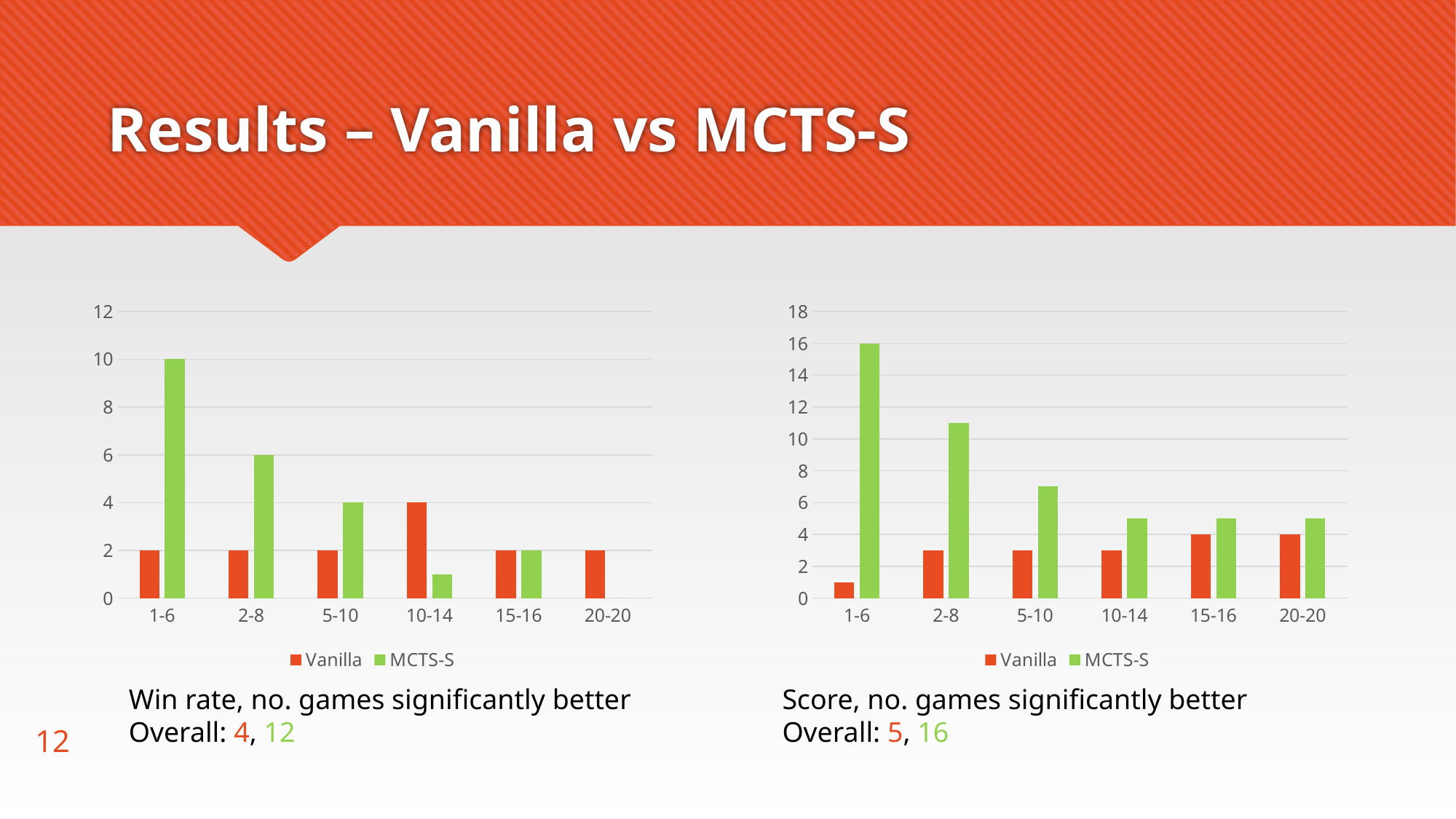
What kind of chart is the right chart (Score, no. games significantly better)? bar chart In the right chart (Score, no. games significantly better), is the Vanilla value for 1-6 greater or less than 2? less In the right chart (Score, no. games significantly better), how many series does the legend list? 2 In the right chart (Score, no. games significantly better), is the MCTS-S value for 2-8 greater or less than 10? greater In the left chart (Win rate, no. games significantly better), what is the Vanilla value for 10-14? 4 In the left chart (Win rate, no. games significantly better), how many categories are shown on the x axis? 6 In the left chart (Win rate, no. games significantly better), what is the difference between the MCTS-S values for 1-6 and 2-8? 4 In the left chart (Win rate, no. games significantly better), what is the MCTS-S value for 1-6? 10 In the left chart (Win rate, no. games significantly better), which category has the highest MCTS-S value? 1-6 In the right chart (Score, no. games significantly better), what is the MCTS-S value for 1-6? 16 In the left chart (Win rate, no. games significantly better), which series has the larger value for 10-14, Vanilla or MCTS-S? Vanilla In the left chart (Win rate, no. games significantly better), what is the MCTS-S value for 20-20? 0